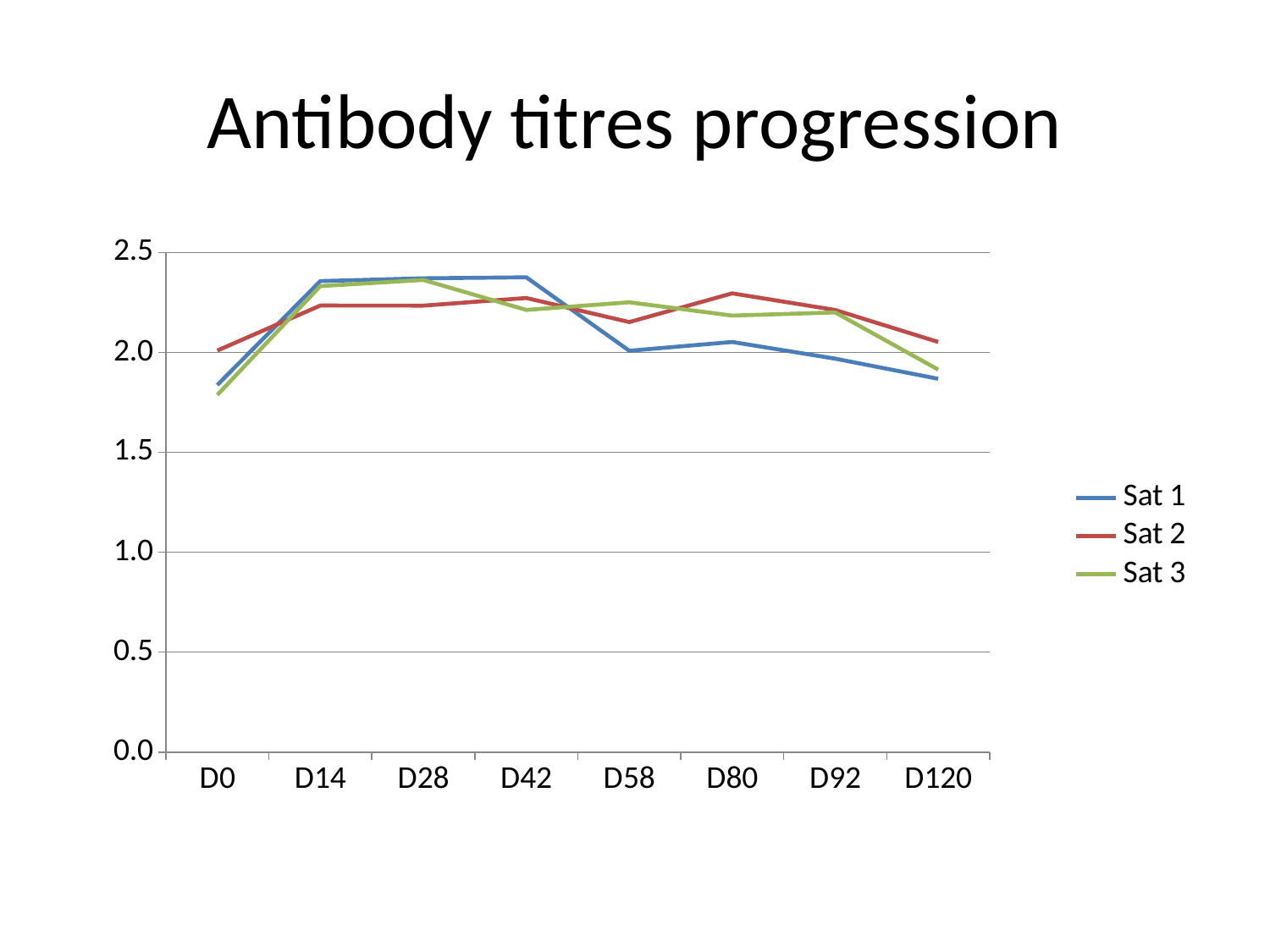
How many series does the legend list? 3 What kind of chart is shown on the slide? line chart Does the Sat 1 line rise or fall from D42 to D120? fall At D58, which series has the larger value, Sat 1 or Sat 2? Sat 2 Is the value for Sat 1 at D14 greater or less than 2.5? less At D0, which series has the larger value, Sat 2 or Sat 3? Sat 2 Is the value for Sat 1 at D0 greater or less than 2.0? less Is the value for Sat 3 at D120 greater or less than 2.0? less How many time points are plotted along the x axis? 8 What is the title of the chart? Antibody titres progression Which series is drawn in green in the legend? Sat 3